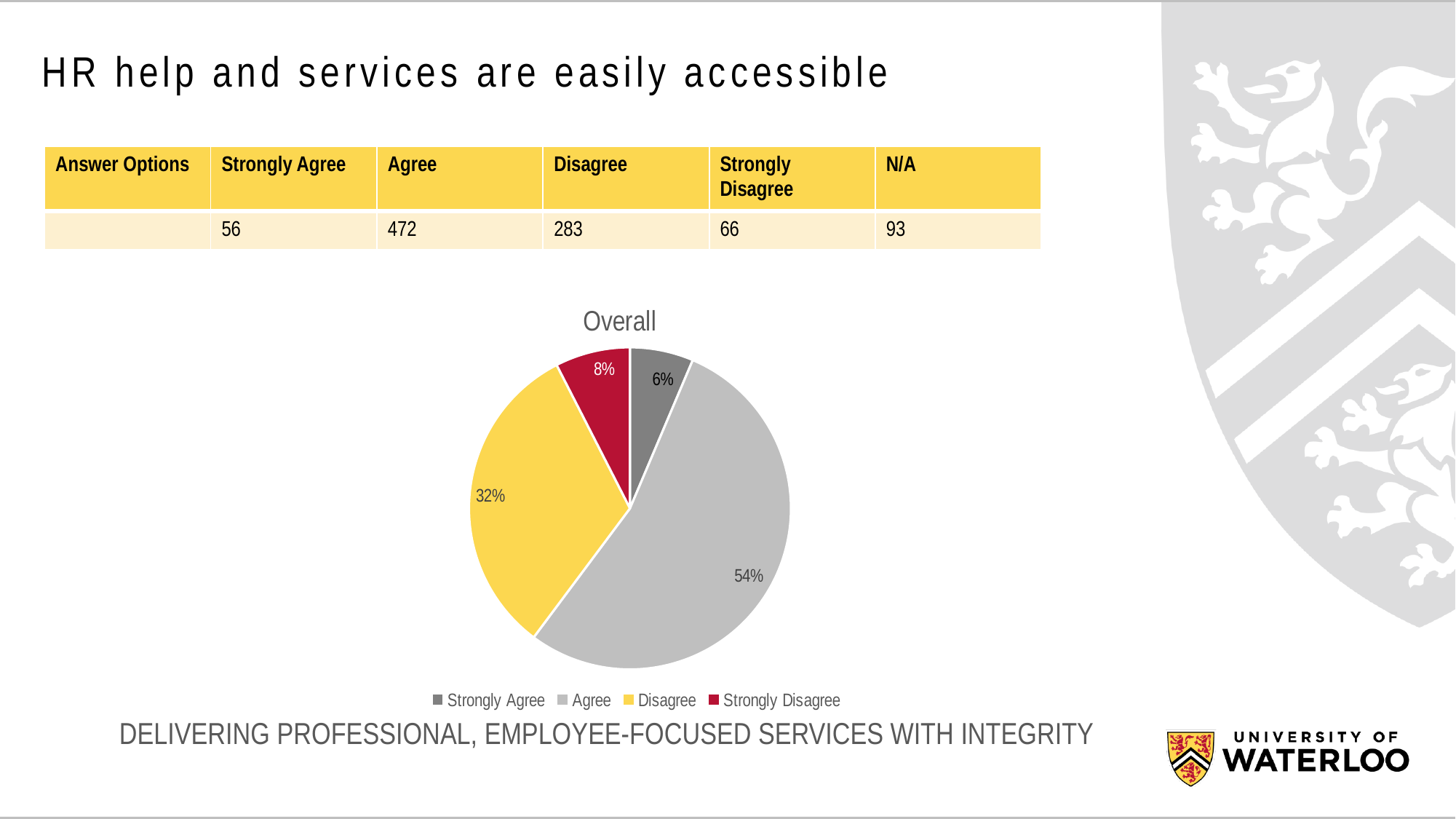
What share of the pie does the Disagree slice represent? 32% What kind of chart is shown on the slide? pie chart What is the difference in percentage points between the Agree and Disagree slices? 22 What share of the pie does the Strongly Agree slice represent? 6% What share of the pie does the Strongly Disagree slice represent? 8% What colour is the Disagree slice in the pie chart? yellow Which category has the smallest slice of the pie? Strongly Agree How many categories does the legend list? 4 Which slice is larger, Strongly Disagree or Strongly Agree? Strongly Disagree What is the title of the chart? Overall Which category has the largest slice of the pie? Agree